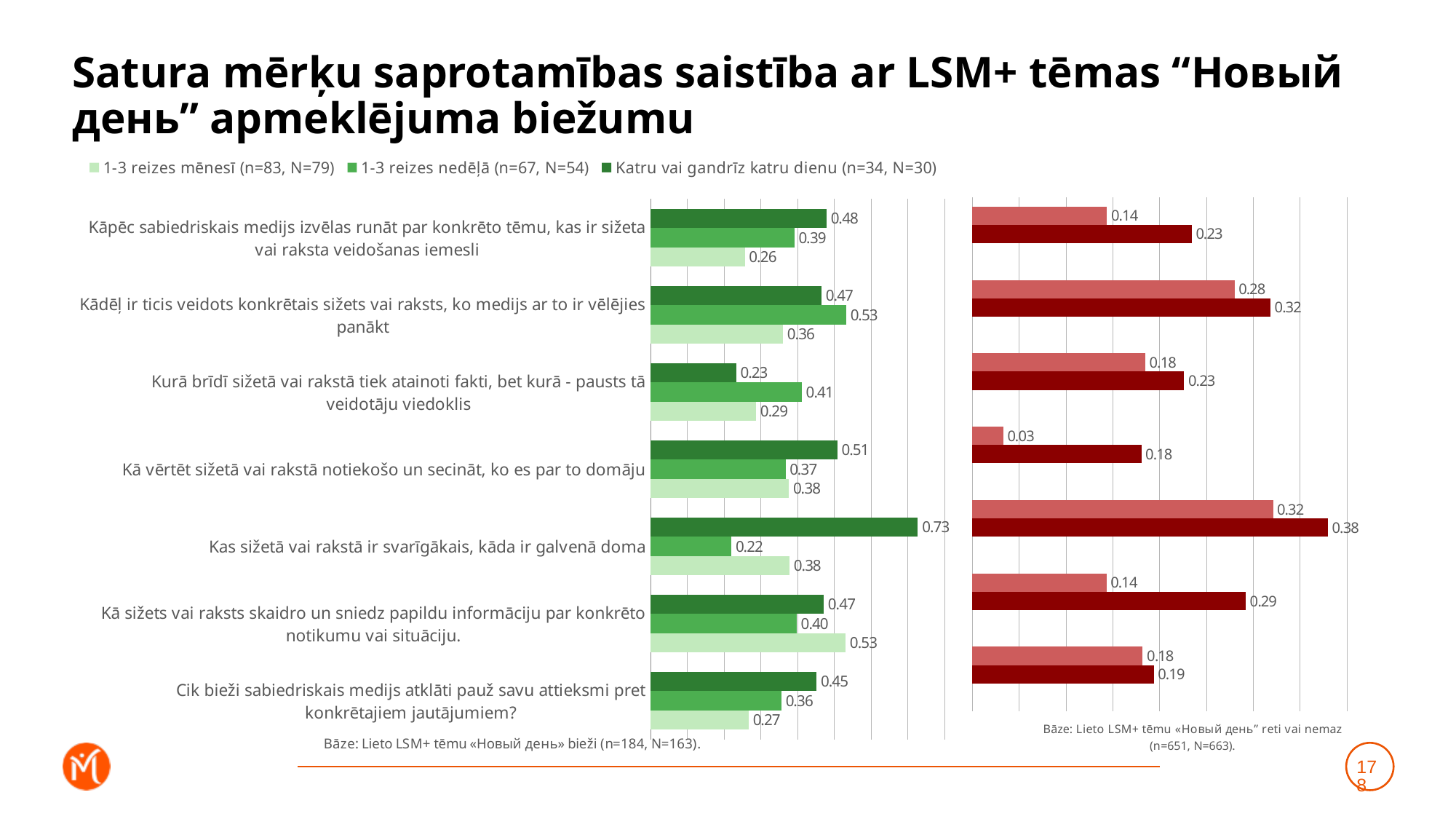
In the left (green) chart, what is the difference between the 'Katru vai gandrīz katru dienu' value and the '1-3 reizes mēnesī' value for 'Kāpēc sabiedriskais medijs izvēlas runāt par konkrēto tēmu, kas ir sižeta vai raksta veidošanas iemesli'? 0.22 How many categories are shown in the left (green) chart? 7 In the left (green) chart, for 'Kādēļ ir ticis veidots konkrētais sižets vai raksts, ko medijs ar to ir vēlējies panākt', which is larger: the '1-3 reizes nedēļā' value or the 'Katru vai gandrīz katru dienu' value? 1-3 reizes nedēļā In the left (green) chart, what is the value for 'Katru vai gandrīz katru dienu' for the category 'Kas sižetā vai rakstā ir svarīgākais, kāda ir galvenā doma'? 0.73 In the left (green) chart, what is the value for '1-3 reizes mēnesī' for the category 'Kā sižets vai raksts skaidro un sniedz papildu informāciju par konkrēto notikumu vai situāciju.'? 0.53 In the left (green) chart, which category has the lowest value for 'Katru vai gandrīz katru dienu'? Kurā brīdī sižetā vai rakstā tiek atainoti fakti, bet kurā - pausts tā veidotāju viedoklis In the left (green) chart, what is the value for '1-3 reizes nedēļā' for the category 'Kurā brīdī sižetā vai rakstā tiek atainoti fakti, bet kurā - pausts tā veidotāju viedoklis'? 0.41 In the right (red) chart, what is the value of the upper (light red) bar for the category 'Kā vērtēt sižetā vai rakstā notiekošo un secināt, ko es par to domāju'? 0.03 In the right (red) chart, what is the value of the lower (dark red) bar for the category 'Kas sižetā vai rakstā ir svarīgākais, kāda ir galvenā doma'? 0.38 What kind of chart is the left (green) chart? Bar chart How many series does the legend of the left (green) chart list? 3 In the left (green) chart, which category has the highest value for 'Katru vai gandrīz katru dienu'? Kas sižetā vai rakstā ir svarīgākais, kāda ir galvenā doma